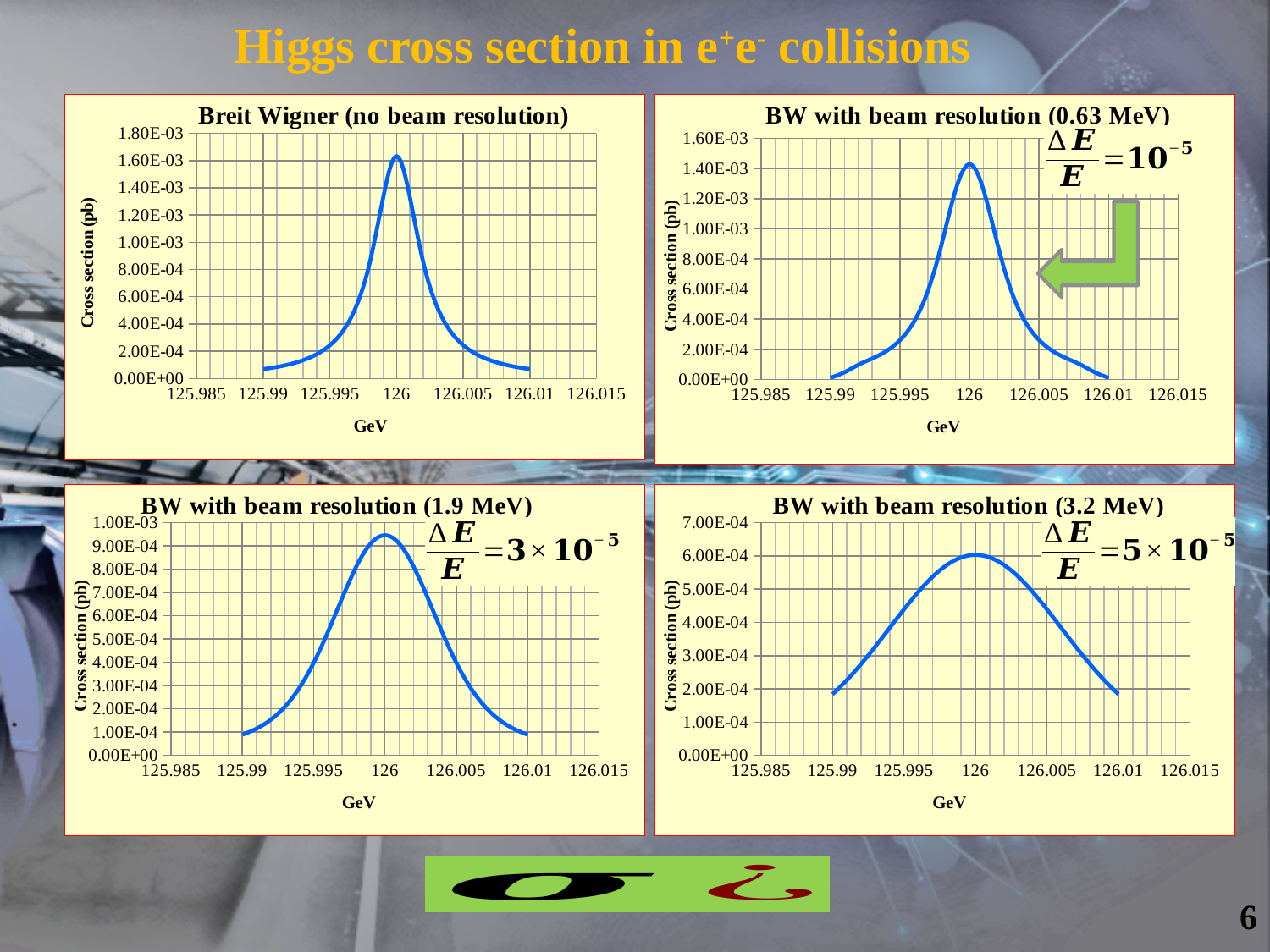
What is the y-axis label of the "BW with beam resolution (0.63 MeV)" chart? Cross section (pb) In the "BW with beam resolution (0.63 MeV)" chart, is the peak value greater or less than 1.20E-03? greater In the "BW with beam resolution (1.9 MeV)" chart, is the peak value greater or less than 8.00E-04? greater In the "BW with beam resolution (3.2 MeV)" chart, is the peak value greater or less than 5.00E-04? greater What kind of chart is the "Breit Wigner (no beam resolution)" chart? line chart In the "Breit Wigner (no beam resolution)" chart, at which x-axis value does the curve reach its peak? 126 How many charts are shown on the slide? 4 What is the x-axis label of the "BW with beam resolution (3.2 MeV)" chart? GeV In the "BW with beam resolution (3.2 MeV)" chart, at which x-axis value does the curve reach its peak? 126 In the "BW with beam resolution (1.9 MeV)" chart, do the values rise or fall between 126 and 126.01 on the x axis? fall Which chart has the higher peak cross section: "Breit Wigner (no beam resolution)" or "BW with beam resolution (3.2 MeV)"? Breit Wigner (no beam resolution)